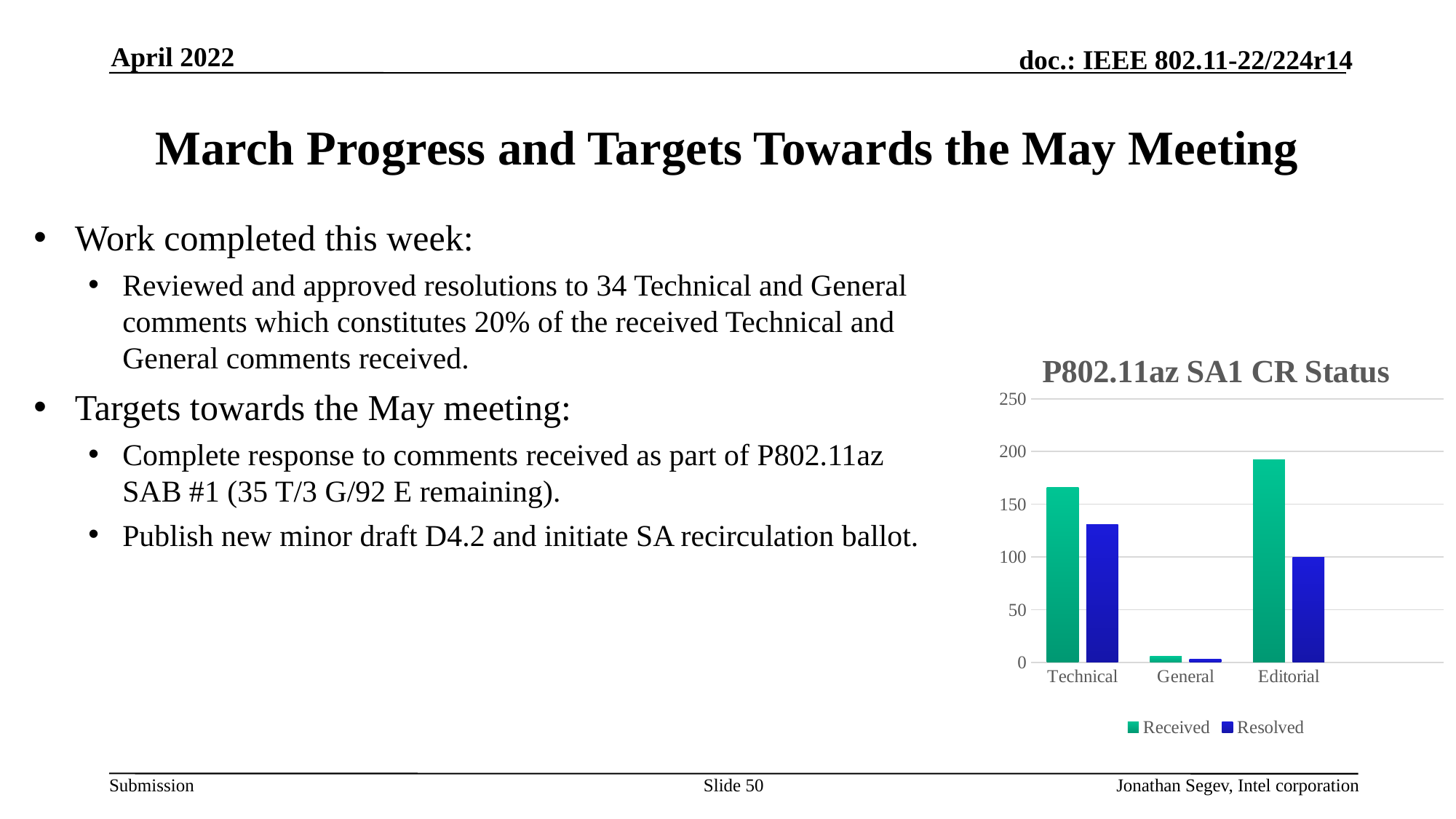
Which category has the lowest Received value? General Which category has the highest Received value? Editorial Which series is shown in dark blue in the chart legend? Resolved Which is larger for Editorial: Received or Resolved? Received How many series does the chart legend list? 2 How many categories are shown on the x axis of the chart? 3 Is the Resolved value for Technical greater or less than 150? less Is the Received value for Technical greater or less than 150? greater Which category has the highest Resolved value? Technical Is the Received value for Editorial greater or less than 200? less What type of chart is shown on the slide? bar chart What is the title of the chart? P802.11az SA1 CR Status